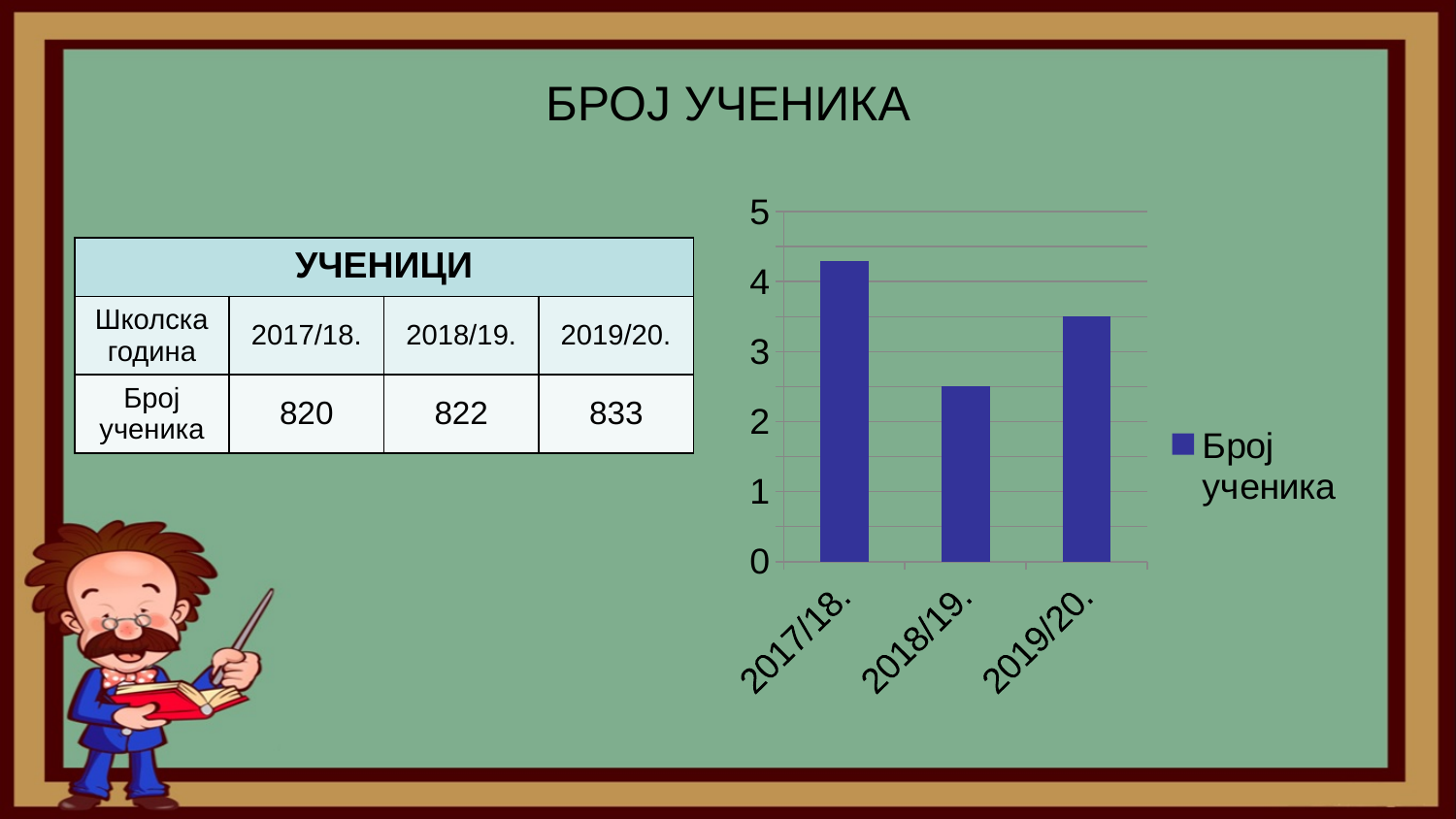
How many series does the chart legend list? 1 How many categories are plotted on the x axis of the chart? 3 Does the bar height rise or fall from 2018/19. to 2019/20. in the chart? rise Which school year has the shortest bar in the chart? 2018/19. In the chart, which bar is taller: 2017/18. or 2019/20.? 2017/18. What kind of chart is shown on the slide? bar chart Is the value for 2018/19. in the chart greater or less than 3? less Which school year has the tallest bar in the chart? 2017/18. Is the value for 2017/18. in the chart greater or less than 4? greater In the chart, which bar is taller: 2018/19. or 2019/20.? 2019/20. Is the value for 2019/20. in the chart greater or less than 3? greater What is the name of the series shown in the chart legend? Број ученика